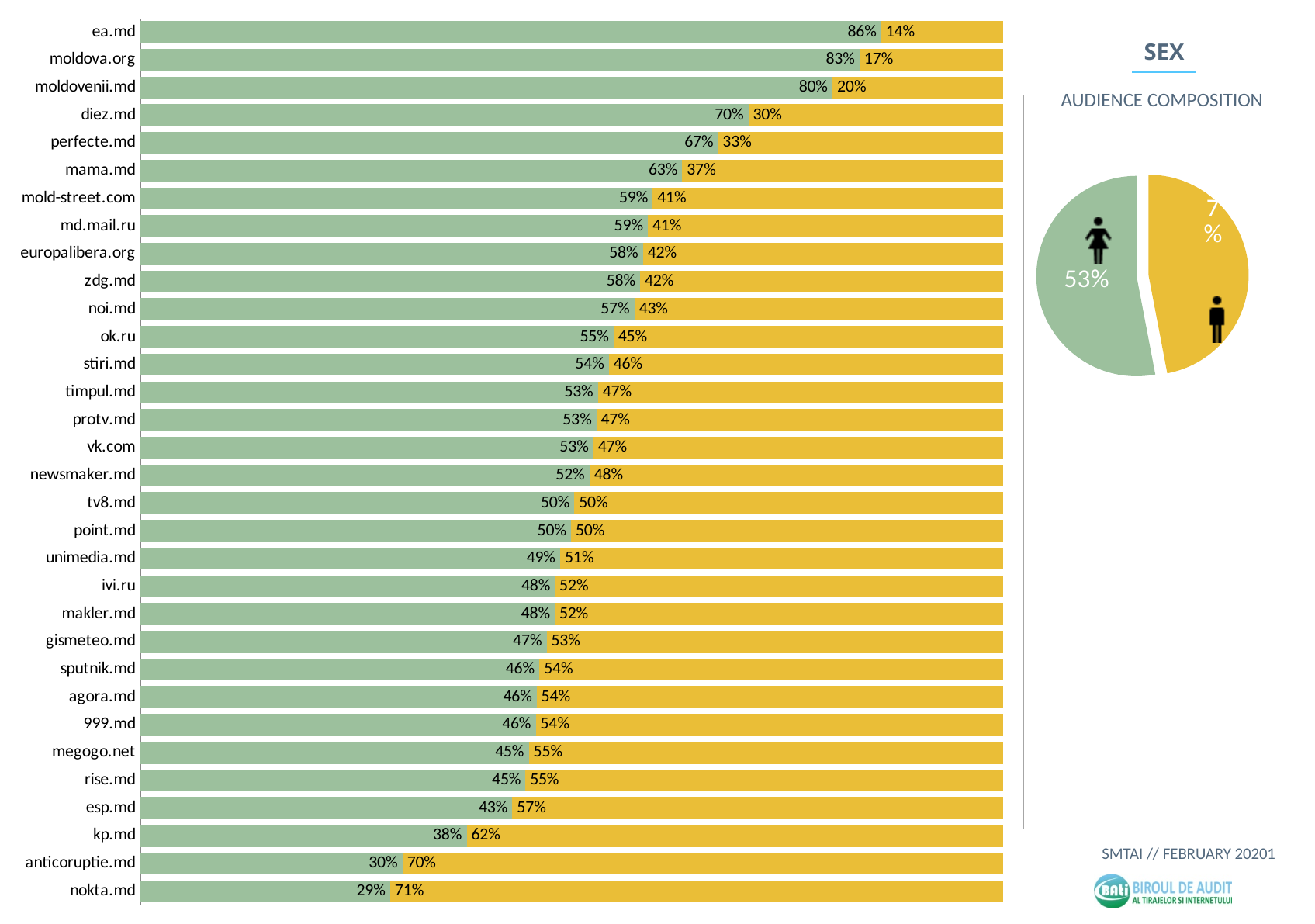
What is the title shown above the pie chart on the right? SEX In the bar chart, what is the difference between the green (female) percentage of ea.md and that of nokta.md? 57 percentage points In the bar chart, what is the total of the two segments for tv8.md? 100% In the bar chart, which site has the highest green (female) percentage? ea.md How many sites are listed in the bar chart? 32 In the bar chart, which site has a larger green (female) percentage, kp.md or esp.md? esp.md In the bar chart, which site has the lowest green (female) percentage? nokta.md In the bar chart, what is the green (female) percentage for diez.md? 70% What kind of chart is the large chart on the left of the slide? Stacked bar chart In the bar chart, what is the yellow (male) percentage for mama.md? 37% In the pie chart on the right, what share is shown for the female (green) slice? 53% In the bar chart, what is the yellow (male) percentage for nokta.md? 71%